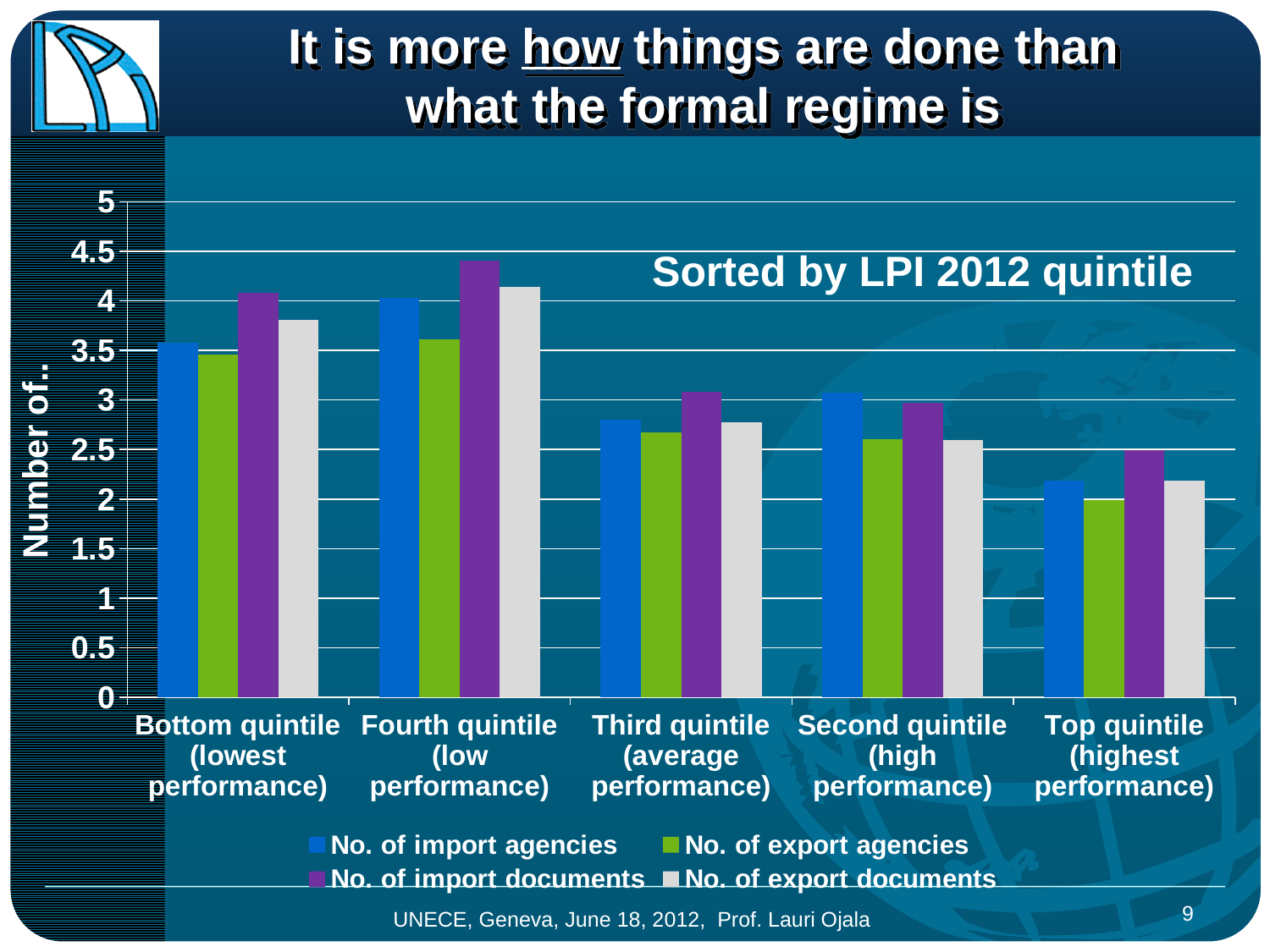
In the Bottom quintile, which is larger: No. of import documents or No. of export documents? No. of import documents Which quintile has the highest value for No. of import documents? Fourth quintile (low performance) Is the value for No. of import documents in the Fourth quintile greater or less than 4? greater Is the value for No. of export documents in the Bottom quintile greater or less than 3.5? greater What annotation text appears inside the chart area? Sorted by LPI 2012 quintile Do the values for No. of import documents rise or fall from the Fourth quintile to the Top quintile? fall How many quintile categories are shown on the x axis? 5 Which quintile has the lowest value for No. of export agencies? Top quintile (highest performance) Is the value for No. of export agencies in the Second quintile greater or less than 3? less How many series does the legend list? 4 What kind of chart is shown on the slide? bar chart